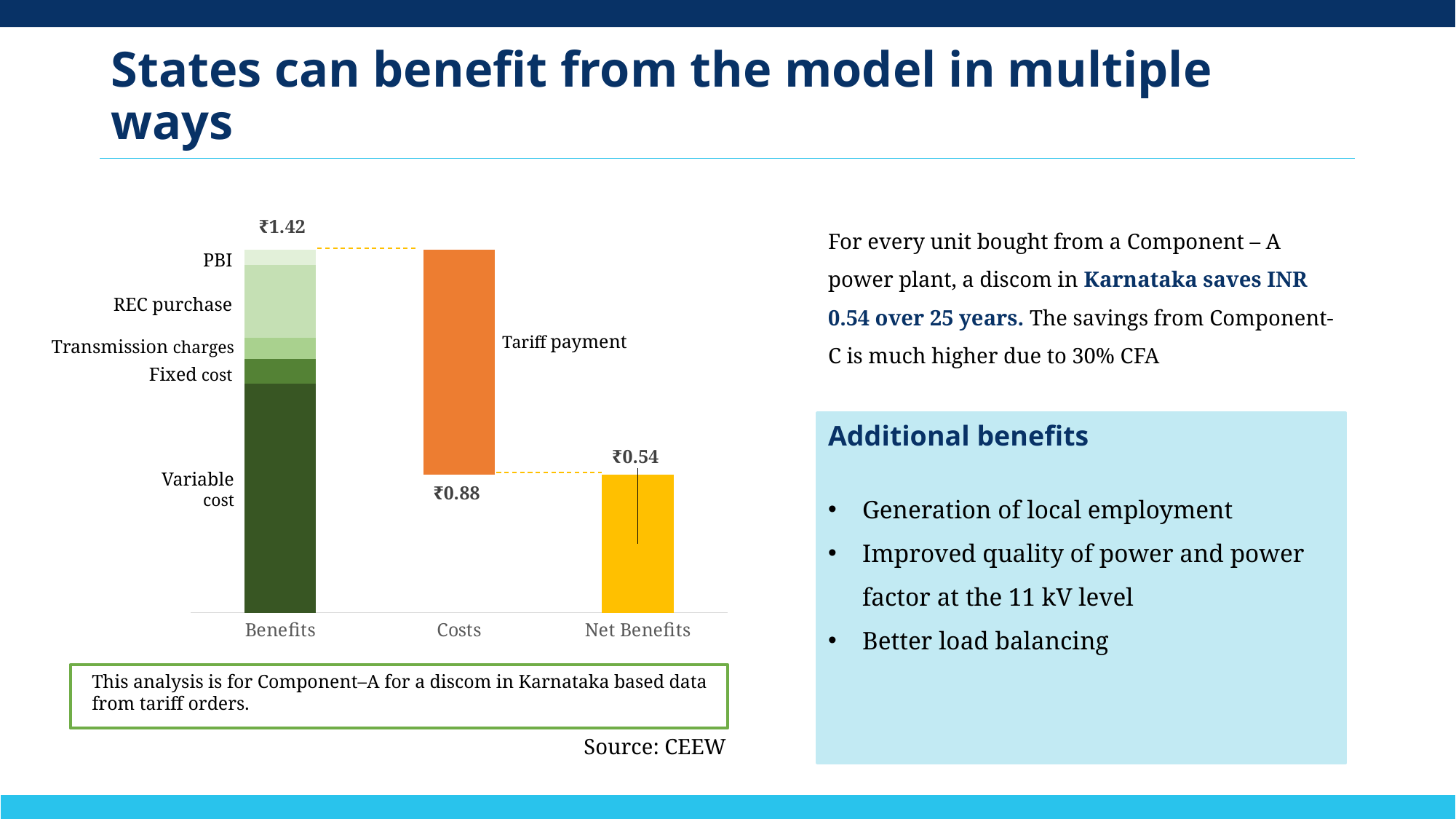
What is the value shown for Net Benefits? ₹0.54 Which is larger, the Costs value or the Net Benefits value? Costs What label is given to the Costs bar? Tariff payment Which segment sits at the top of the Benefits bar? PBI What is the total value of the Benefits bar? ₹1.42 Which category has the highest value? Benefits What is the difference between the Benefits value and the Costs value? ₹0.54 What kind of chart is shown on the slide? Bar chart Which category has the lowest value? Net Benefits What is the value shown for Costs? ₹0.88 How many categories are shown on the x axis? 3 Which segment of the Benefits bar is the largest? Variable cost